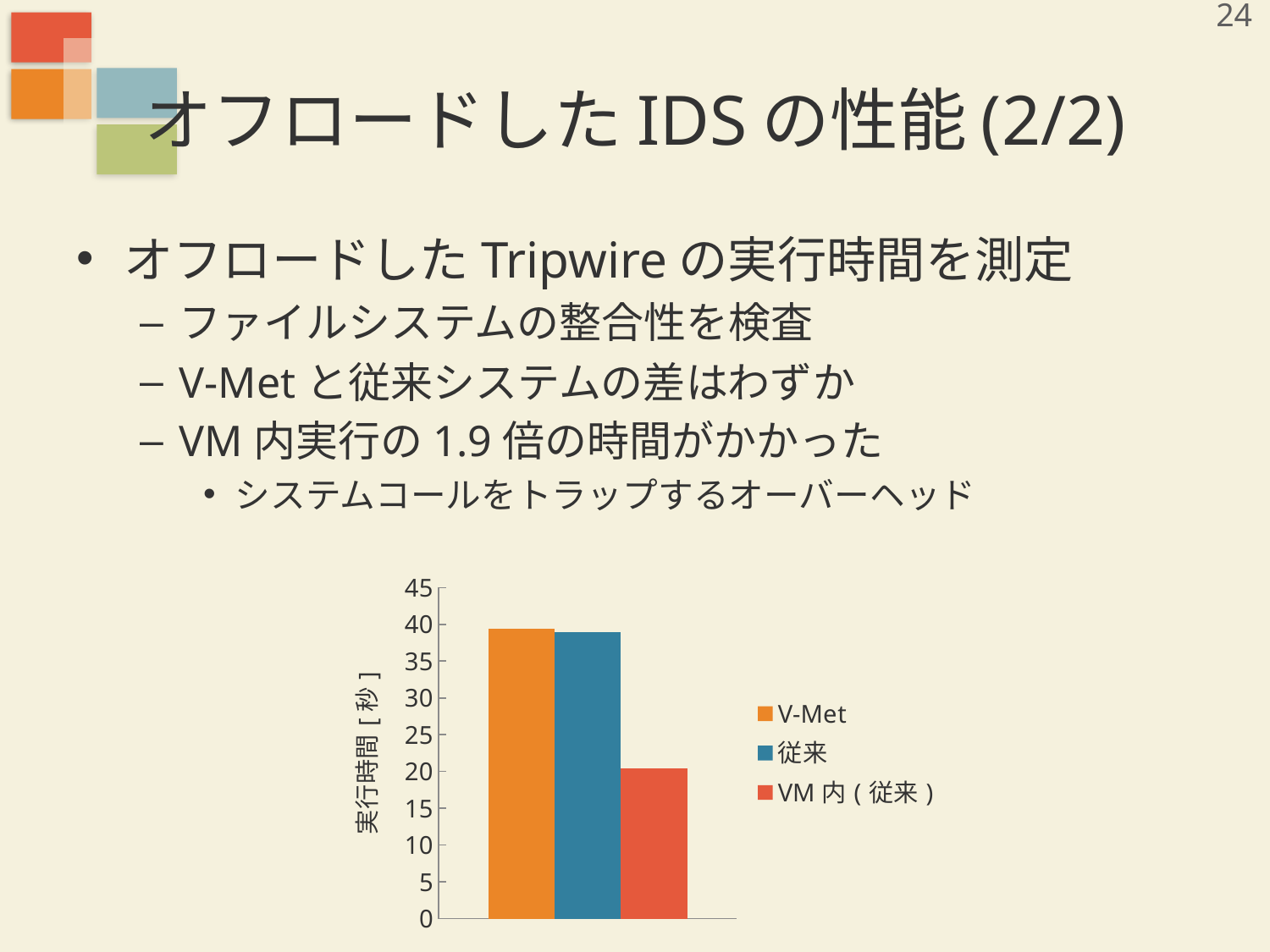
Is the value for VM 内 ( 従来 ) greater or less than 25? less What kind of chart is shown on the slide? bar chart What is the label of the vertical axis of the chart? 実行時間 [ 秒 ] How many series does the chart legend list? 3 Which is larger, the value for V-Met or the value for VM 内 ( 従来 )? V-Met Is the value for VM 内 ( 従来 ) greater or less than 15? greater What colour is the bar for V-Met in the chart? orange Is the value for V-Met greater or less than 35? greater Which is larger, the value for 従来 or the value for VM 内 ( 従来 )? 従来 Which series has the lowest execution time in the chart? VM 内 ( 従来 ) What is the highest tick value shown on the vertical axis? 45